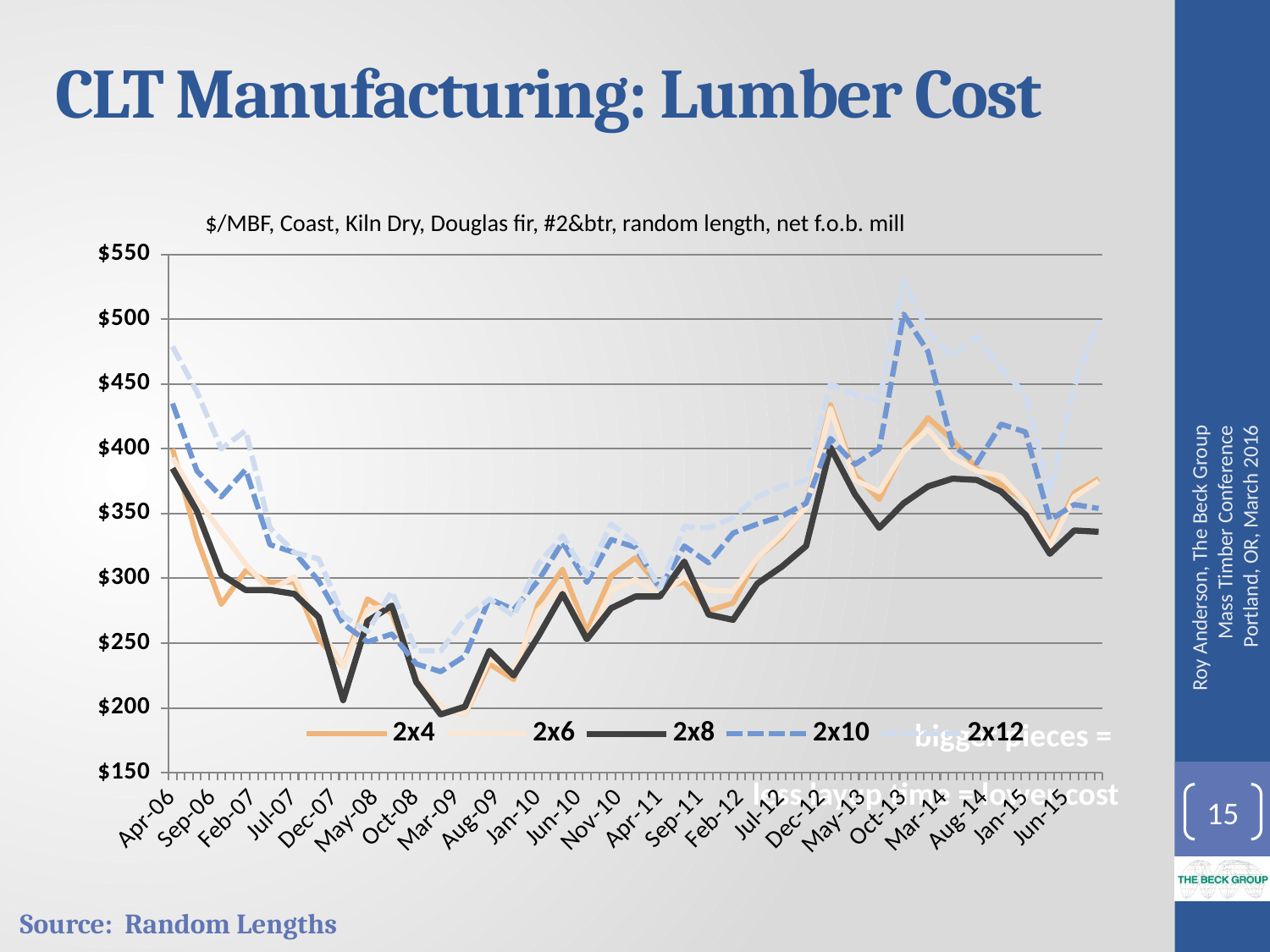
Is the value for 2x8 at Jun-15 greater or less than $300? greater Is the value for 2x8 at Apr-06 greater or less than $350? greater Is the value for 2x12 at Apr-06 greater or less than $450? greater What kind of chart is shown on the slide? line chart At Apr-06, which series has the higher value, 2x12 or 2x8? 2x12 What is the source cited for the chart? Random Lengths At Oct-13, which series has the higher value, 2x10 or 2x8? 2x10 Does the 2x8 series rise or fall between Apr-06 and Mar-09? fall Which series is drawn as the solid black line? 2x8 How many series does the chart legend list? 5